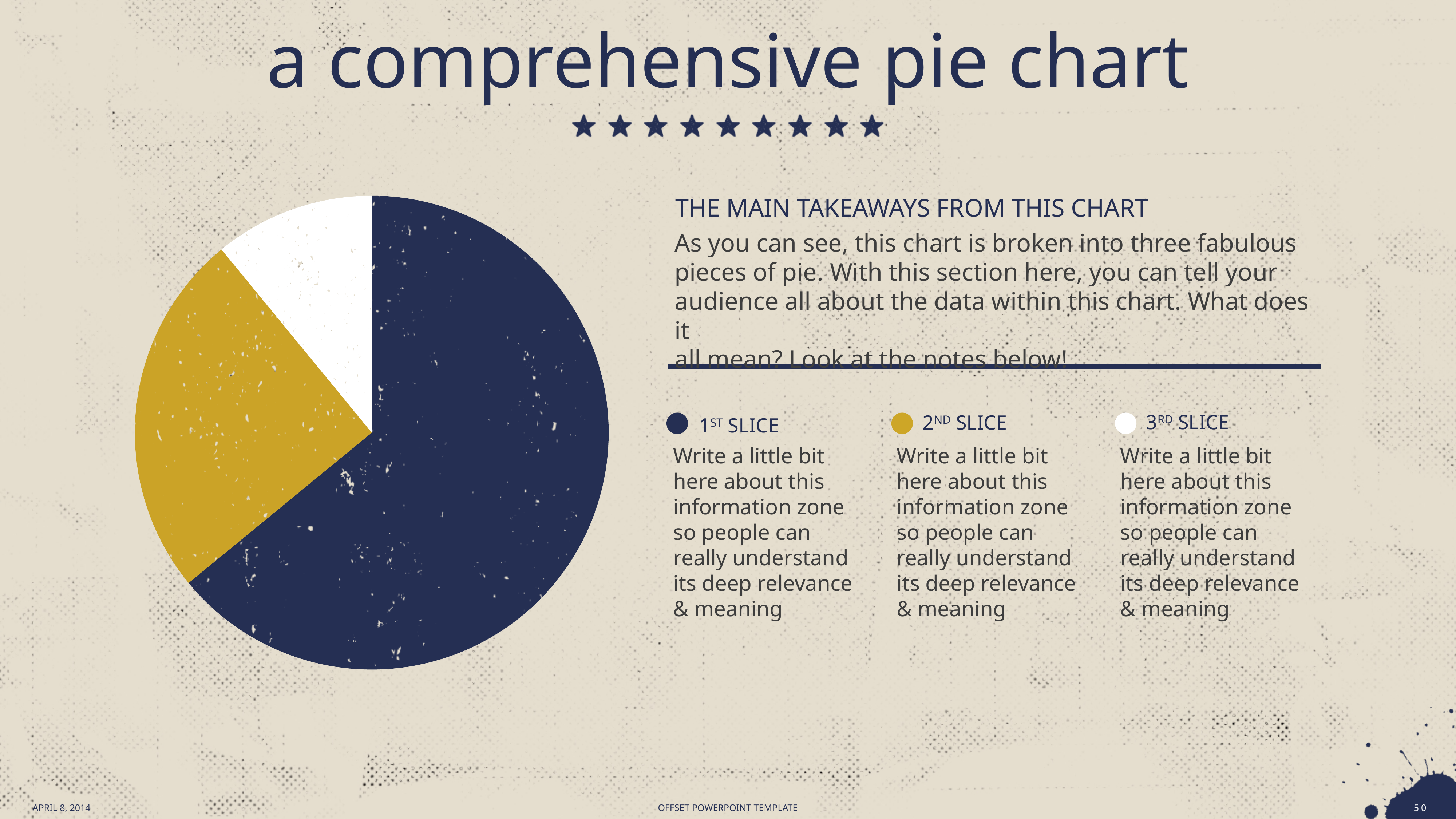
Which slice is the smallest in the pie chart? 3rd Slice Which is larger in the pie chart, the 2nd Slice or the 3rd Slice? 2nd Slice What is the title of the slide containing the pie chart? a comprehensive pie chart What kind of chart is shown on the slide? pie chart Does the 1st Slice take up more or less than half of the pie? more What colour is the 2nd Slice in the pie chart? gold How many slices does the pie chart have? 3 Which is larger in the pie chart, the 1st Slice or the 2nd Slice? 1st Slice Which slice is the largest in the pie chart? 1st Slice